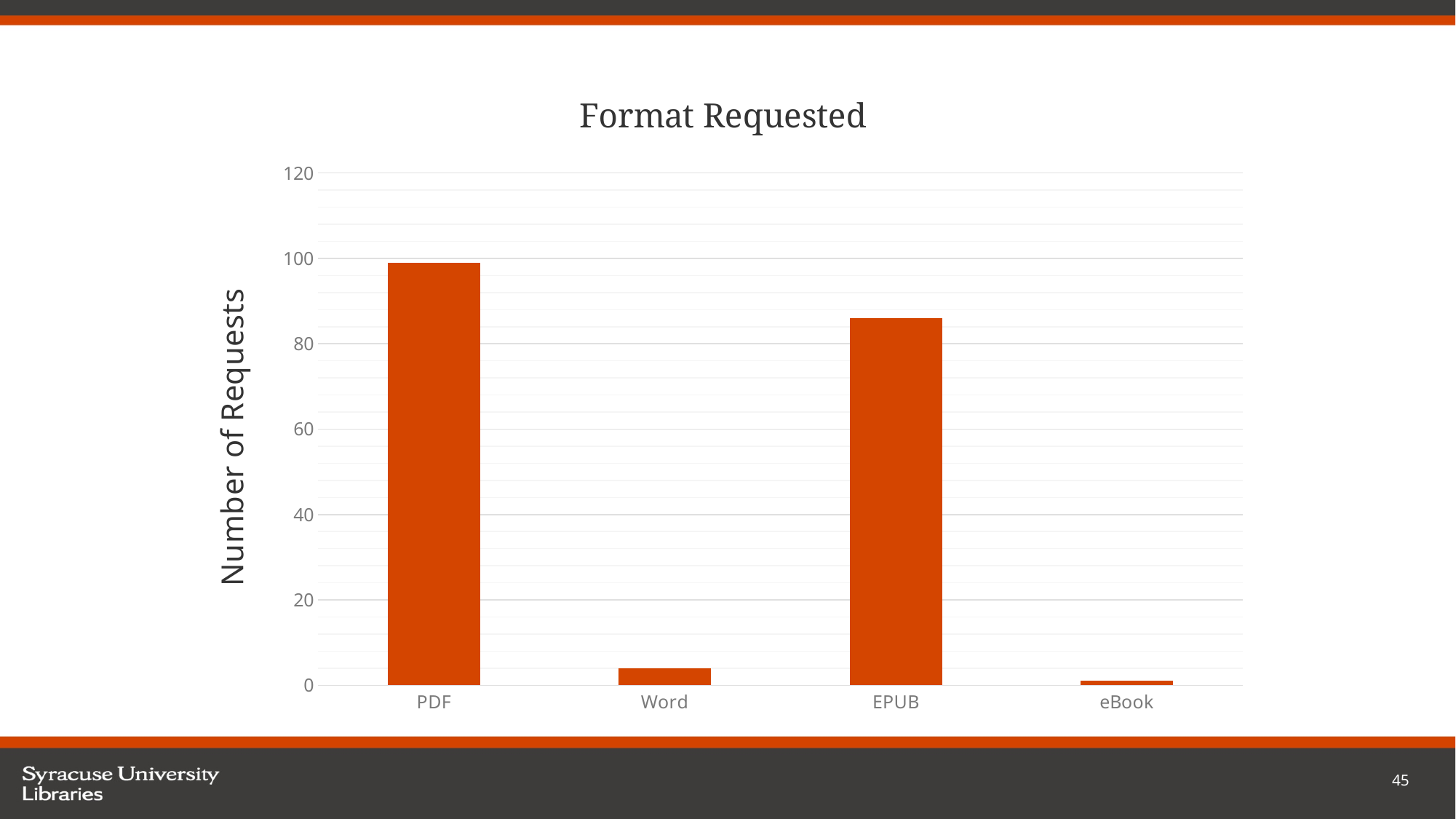
Is the value for EPUB greater or less than 100? less How many categories are shown on the x axis of the chart? 4 Which format has the highest number of requests? PDF Which format has the lowest number of requests? eBook What kind of chart is shown on the slide? bar chart Is the value for PDF greater or less than 80? greater What is the title of the chart? Format Requested What is the label on the vertical axis of the chart? Number of Requests Which has more requests, PDF or EPUB? PDF Is the value for EPUB greater or less than 60? greater Which has more requests, Word or EPUB? EPUB